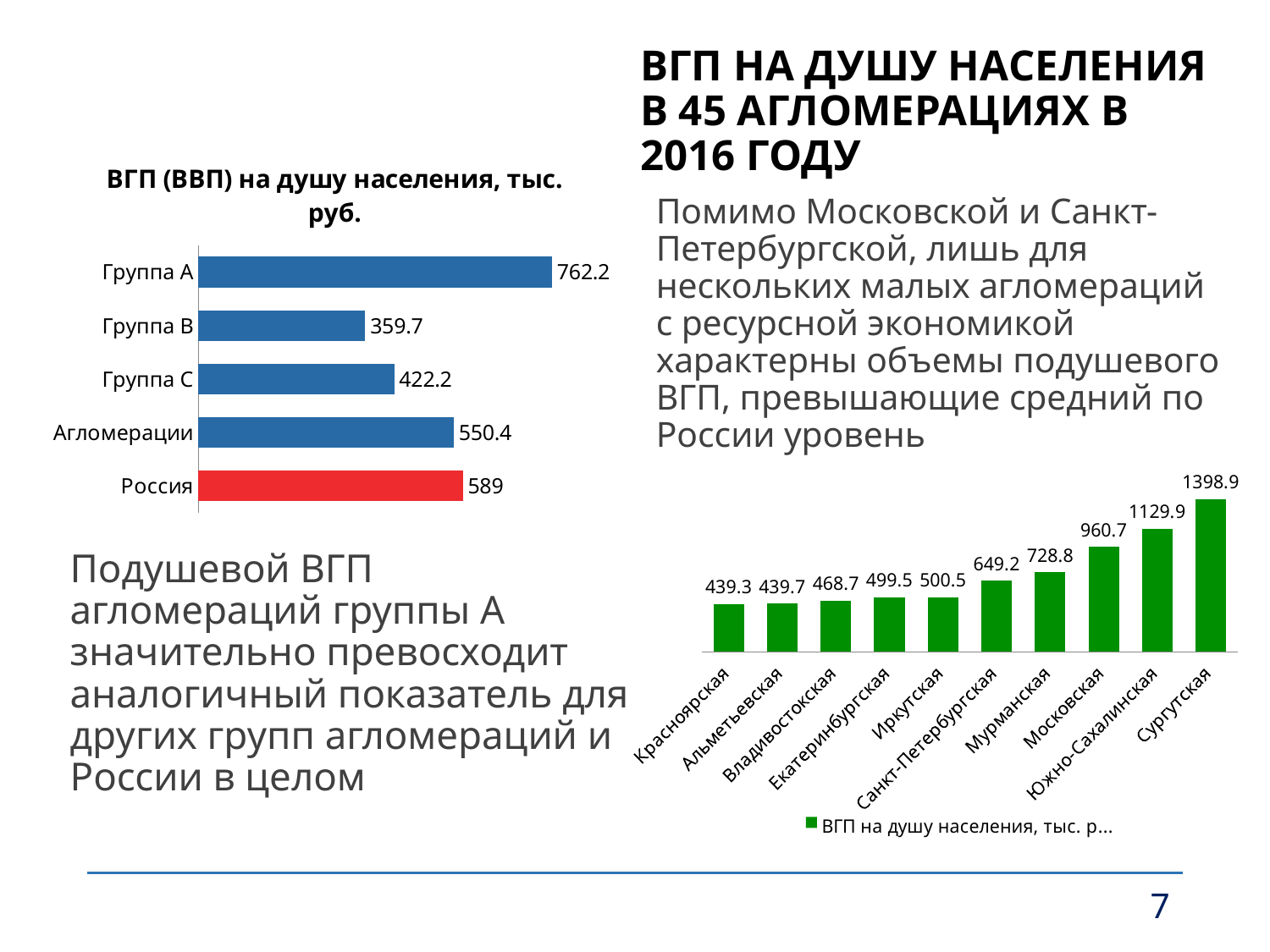
In the left chart titled "ВГП (ВВП) на душу населения, тыс. руб.", how many categories are shown? 5 In the left chart titled "ВГП (ВВП) на душу населения, тыс. руб.", which is larger: Группа C or Россия? Россия In the bar chart at the bottom right of the slide, do the values rise or fall from left to right? rise In the bar chart at the bottom right of the slide, what is the value for Московская? 960.7 In the bar chart at the bottom right of the slide, how many agglomerations are shown? 10 In the left chart titled "ВГП (ВВП) на душу населения, тыс. руб.", which bar is coloured red? Россия In the left chart titled "ВГП (ВВП) на душу населения, тыс. руб.", which category has the lowest value? Группа B In the bar chart at the bottom right of the slide, what is the value for Сургутская? 1398.9 In the bar chart at the bottom right of the slide, which agglomeration has the highest value? Сургутская In the left chart titled "ВГП (ВВП) на душу населения, тыс. руб.", what is the value for Группа A? 762.2 In the left chart titled "ВГП (ВВП) на душу населения, тыс. руб.", what is the difference between Группа A and Агломерации? 211.8 In the left chart titled "ВГП (ВВП) на душу населения, тыс. руб.", what is the value for Россия? 589